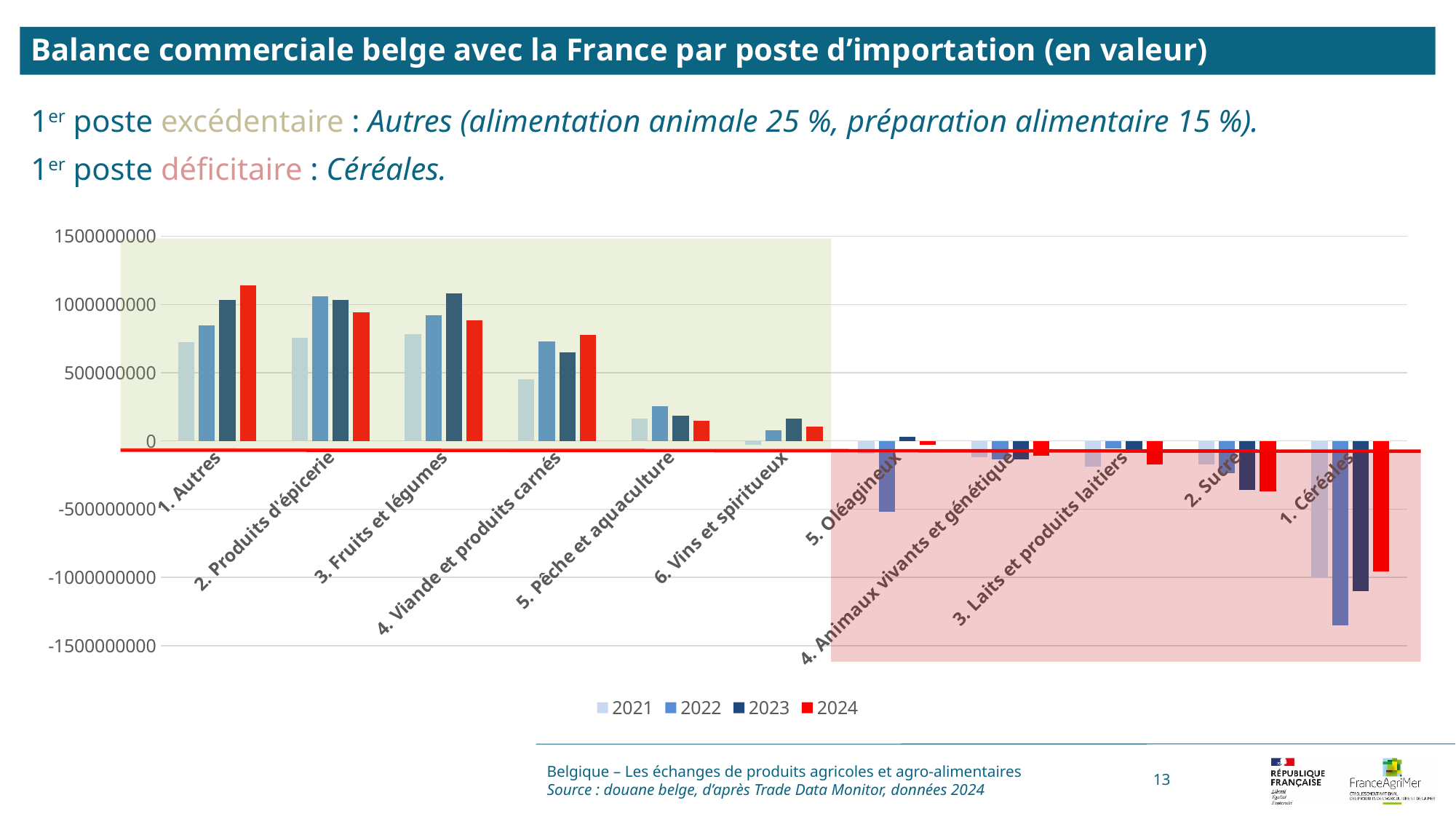
How many import categories are shown along the x axis of the chart? 11 Is the 2024 value for 1. Autres greater or less than 1000000000? greater Which category has the lowest 2022 value in the chart? 1. Céréales How many series does the chart legend list? 4 For the category 1. Autres, do the values rise or fall from 2021 to 2024? rise Which is larger, the 2024 value for 1. Autres or the 2024 value for 3. Fruits et légumes? 1. Autres What kind of chart is shown on the slide? bar chart Is the 2021 value for 4. Viande et produits carnés greater or less than 500000000? less Which colour represents the 2024 series in the chart legend? red Is the 2024 value for 2. Produits d'épicerie greater or less than 1000000000? less Which category has the highest 2024 value in the chart? 1. Autres